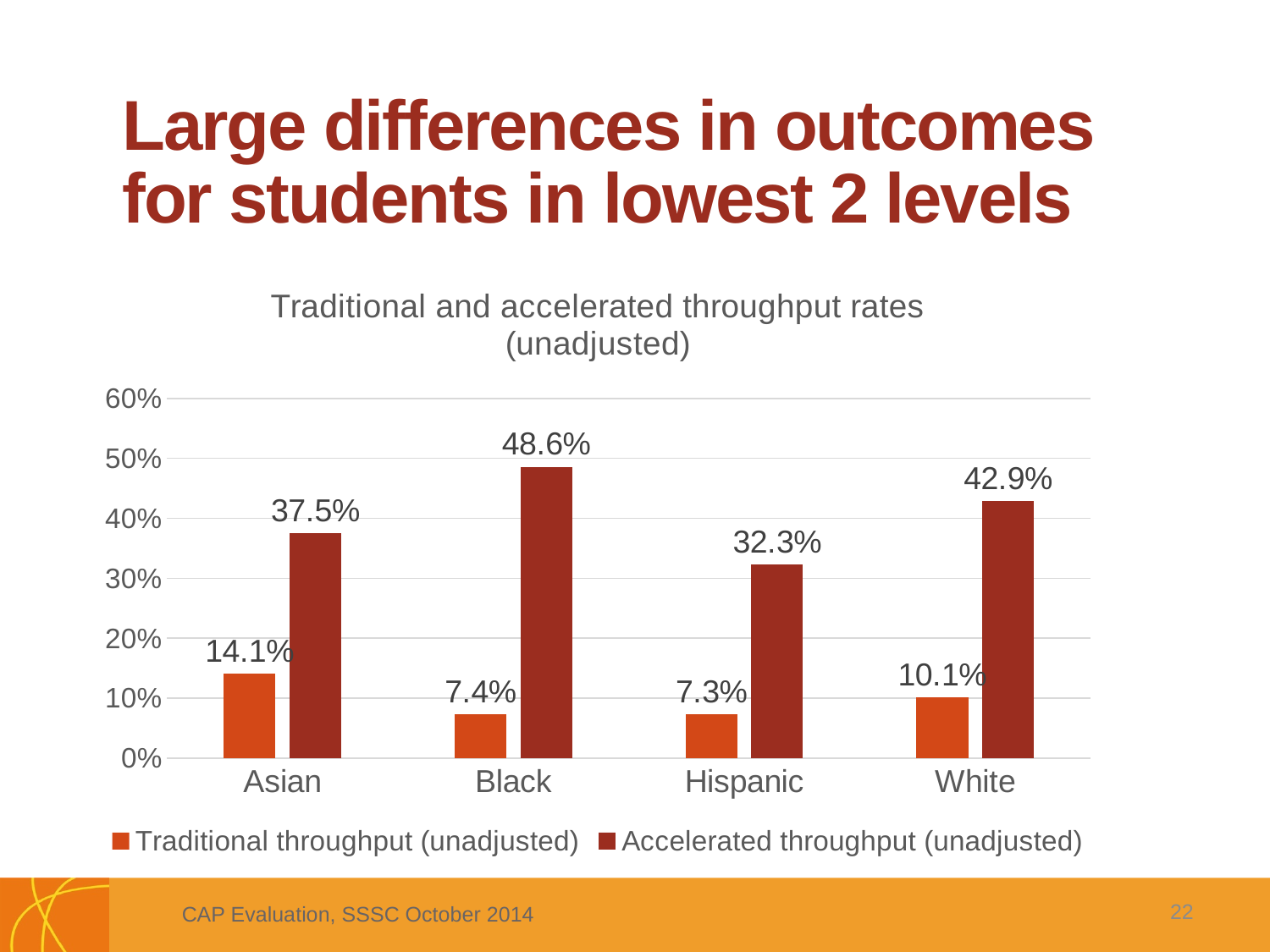
What is the Accelerated throughput (unadjusted) value for Black students? 48.6% What is the Traditional throughput (unadjusted) value for Asian students? 14.1% Which category has the lowest Traditional throughput (unadjusted) value? Hispanic What is the difference between the Accelerated and Traditional throughput (unadjusted) values for Hispanic students? 25.0% How many series does the legend list? 2 What is the title of the chart? Traditional and accelerated throughput rates (unadjusted) Which is larger: the Accelerated throughput (unadjusted) value for Asian students or for White students? White What kind of chart is shown on the slide? Bar chart How many categories are shown on the x axis? 4 Which category has the highest Accelerated throughput (unadjusted) value? Black Is the Accelerated throughput (unadjusted) value for Hispanic students greater or less than 40%? less What is the Accelerated throughput (unadjusted) value for White students? 42.9%